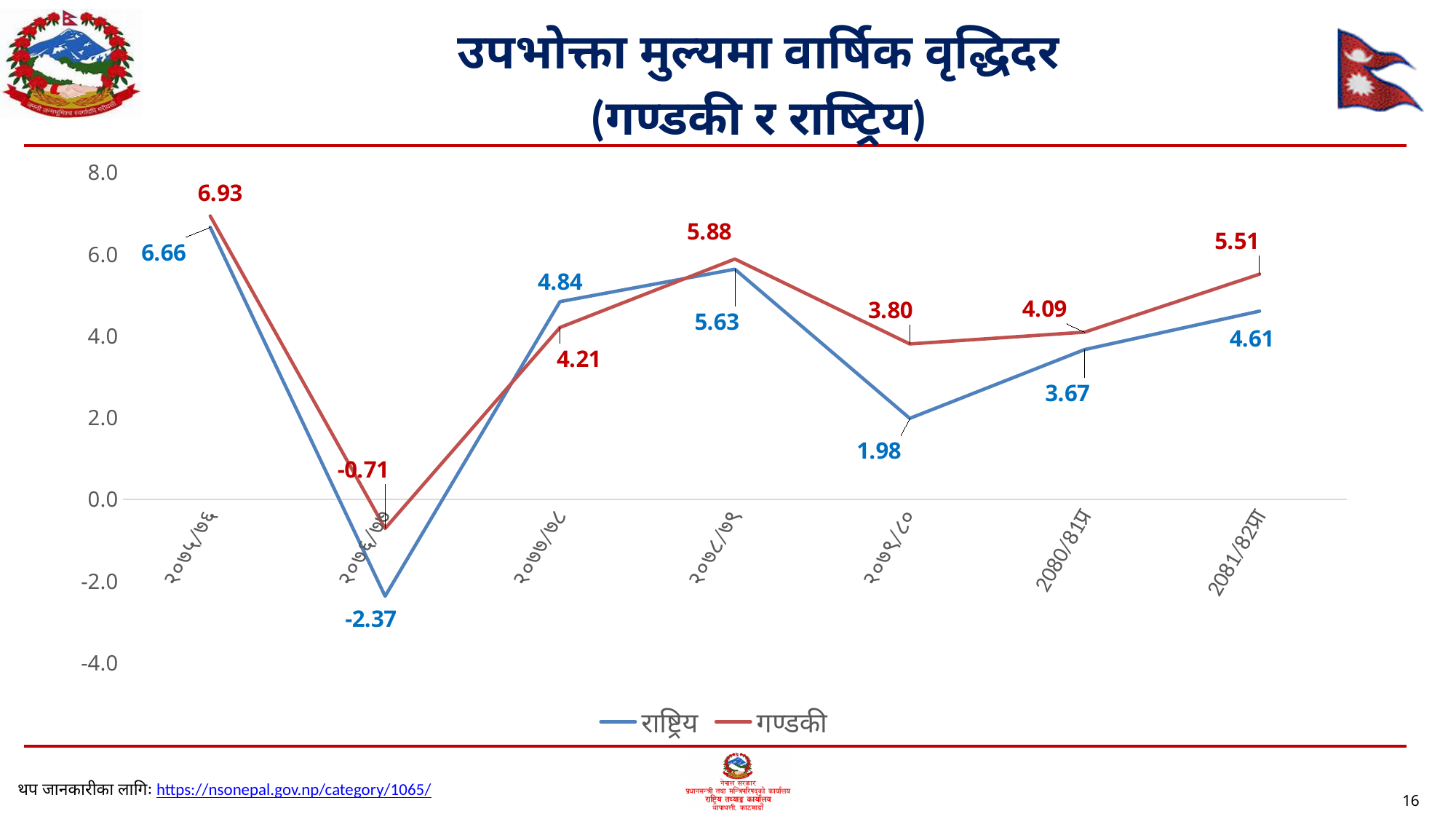
What is the value for गण्डकी in 2081/82प्रा? 5.51 Which series has the larger value in २०७७/७८, राष्ट्रिय or गण्डकी? राष्ट्रिय What is the difference between गण्डकी and राष्ट्रिय in २०७९/८०? 1.82 What kind of chart is shown on the slide? Line chart Which colour is used for the गण्डकी series? Red In which year is the राष्ट्रिय series lowest? २०७६/७७ What is the value for गण्डकी in २०७६/७७? -0.71 How many years are shown on the x axis? 7 What is the value for राष्ट्रिय in २०७९/८०? 1.98 In which year is the गण्डकी series highest? २०७५/७६ What is the value for राष्ट्रिय in २०७५/७६? 6.66 How many series does the legend list? 2